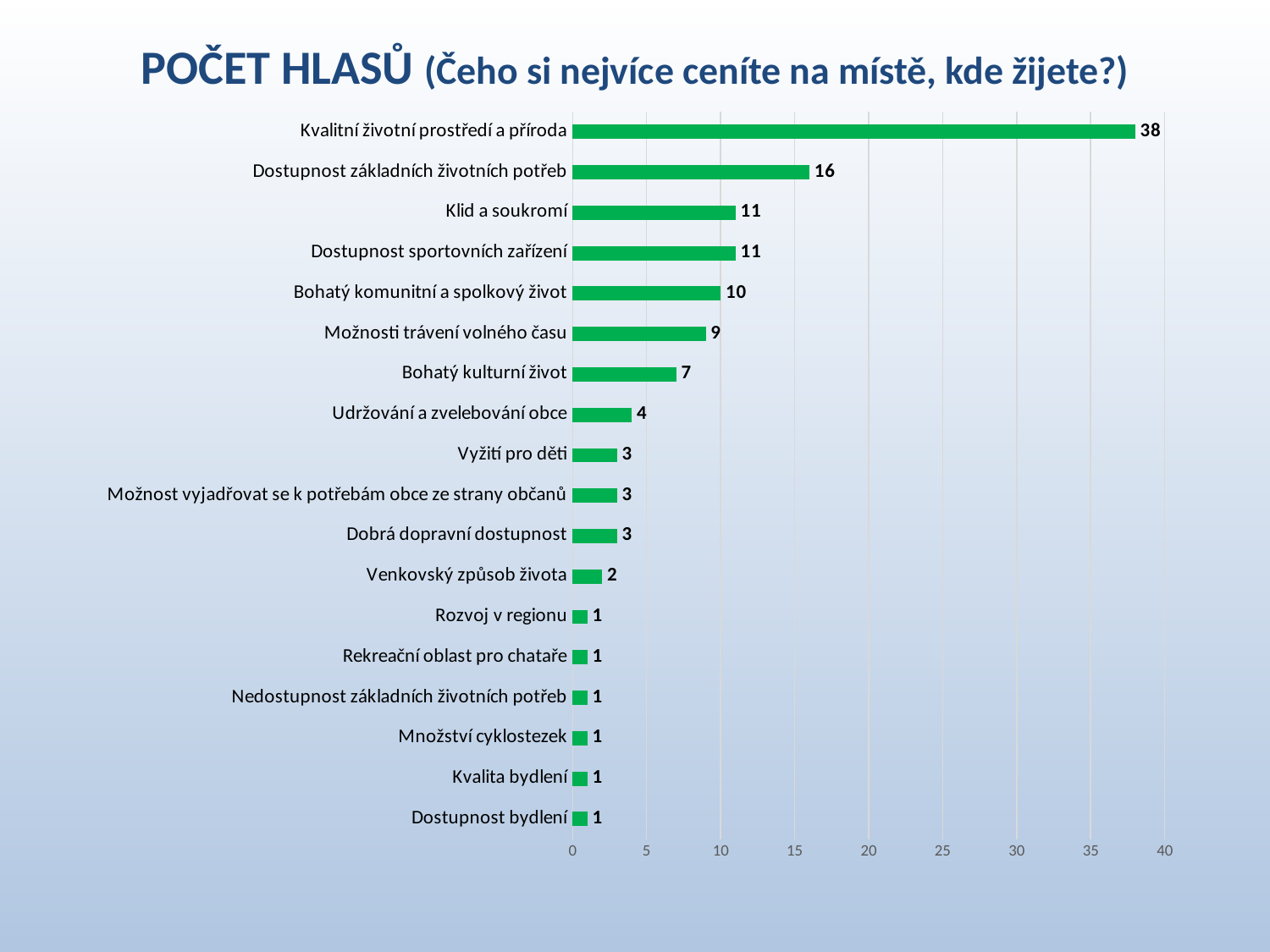
What is the value for "Dostupnost základních životních potřeb"? 16 Is the value for "Klid a soukromí" greater or less than 10? greater How many categories are shown in the chart? 18 What is the difference between "Kvalitní životní prostředí a příroda" and "Dostupnost základních životních potřeb"? 22 What is the value for "Bohatý kulturní život"? 7 How many categories have a value of 1? 6 What is the title of the chart? POČET HLASŮ (Čeho si nejvíce ceníte na místě, kde žijete?) What is the value for "Kvalitní životní prostředí a příroda"? 38 What is the value for "Udržování a zvelebování obce"? 4 What kind of chart is shown on the slide? bar chart Which is larger: "Bohatý komunitní a spolkový život" or "Možnosti trávení volného času"? Bohatý komunitní a spolkový život Which category has the highest number of votes? Kvalitní životní prostředí a příroda